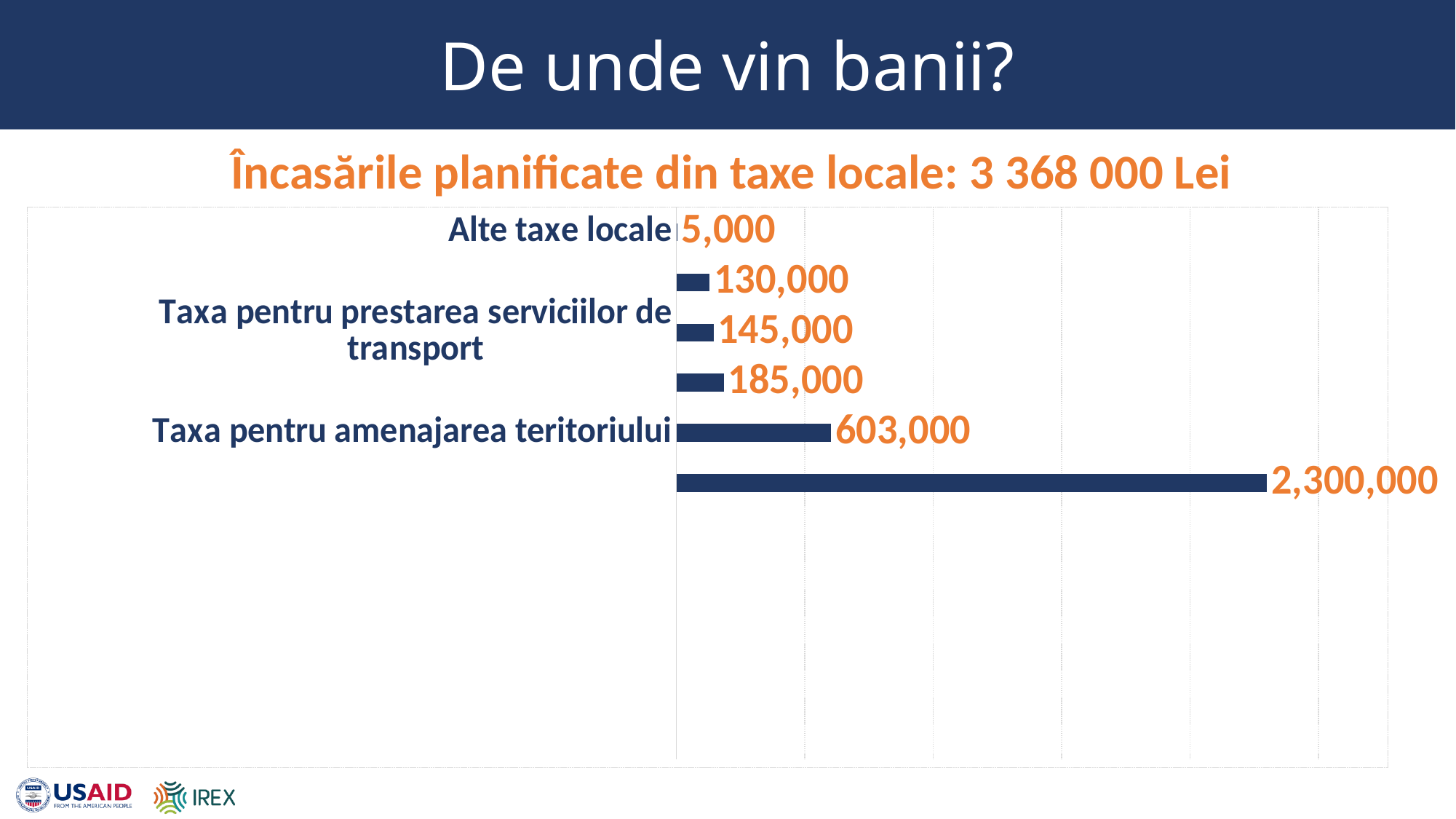
What is the value for Alte taxe locale? 5,000 What is the largest value shown on the chart? 2,300,000 Which is larger: Taxa pentru amenajarea teritoriului or Taxa pentru prestarea serviciilor de transport? Taxa pentru amenajarea teritoriului What is the title of the chart? Încasările planificate din taxe locale: 3 368 000 Lei How many bars are plotted on the chart? 6 What is the difference between Taxa pentru amenajarea teritoriului and Taxa pentru prestarea serviciilor de transport? 458,000 What total planned revenue from local taxes is stated in the chart title? 3 368 000 Lei Which category has the lowest value? Alte taxe locale What is the value for Taxa pentru prestarea serviciilor de transport? 145,000 What is the difference between Taxa pentru prestarea serviciilor de transport and Alte taxe locale? 140,000 What is the value for Taxa pentru amenajarea teritoriului? 603,000 What kind of chart is shown on the slide? Bar chart